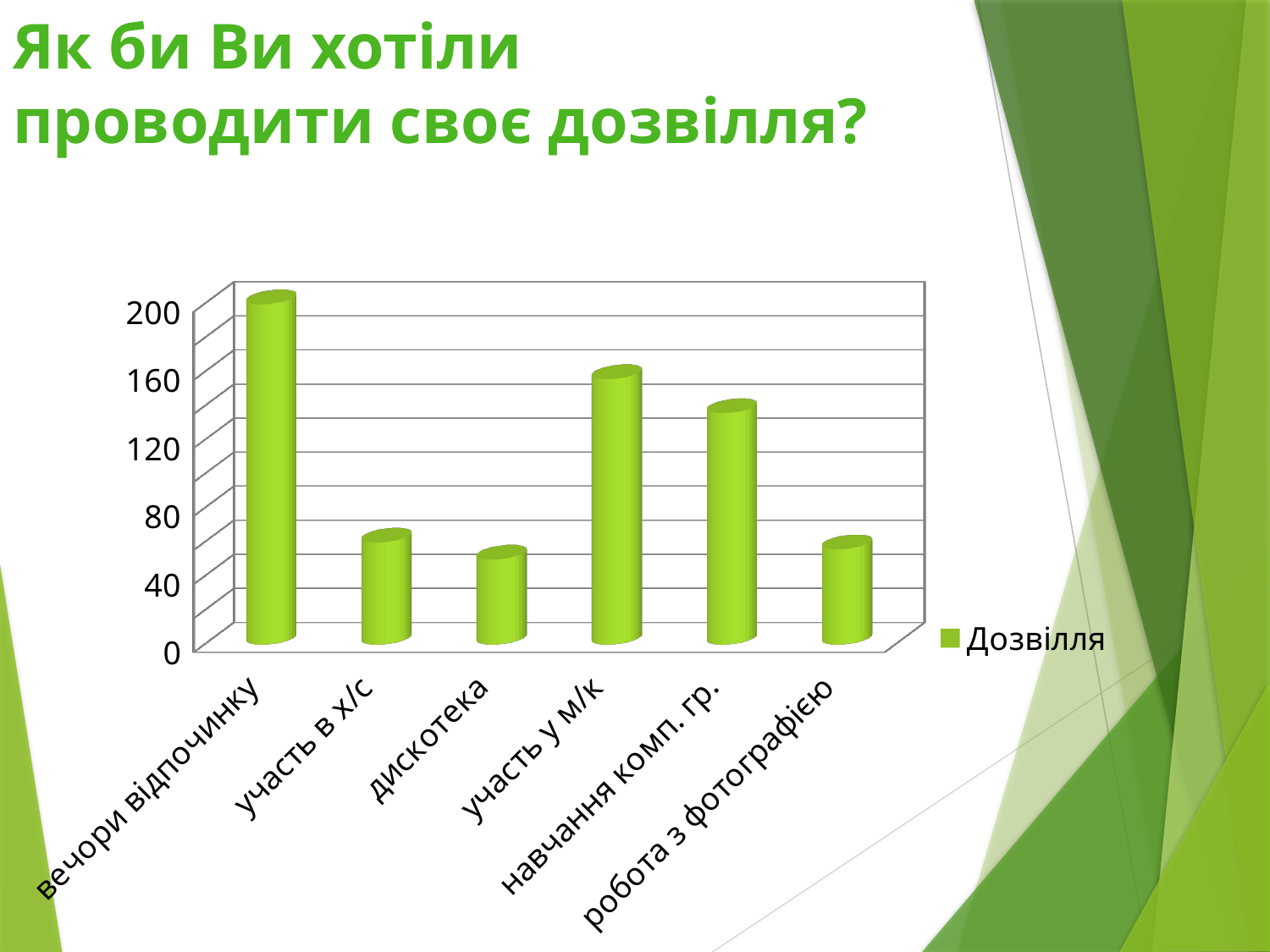
Which is larger, the value for участь у м/к or the value for навчання комп. гр.? участь у м/к How many categories are shown on the x axis of the chart? 6 What is the name of the series shown in the chart legend? Дозвілля Is the value for участь у м/к greater or less than 120? greater How many series does the chart legend list? 1 Which category has the highest value in the chart? вечори відпочинку What kind of chart is shown on the slide? bar chart Is the value for участь в х/с greater or less than 80? less Is the value for вечори відпочинку greater or less than 160? greater Which is larger, the value for вечори відпочинку or the value for участь в х/с? вечори відпочинку